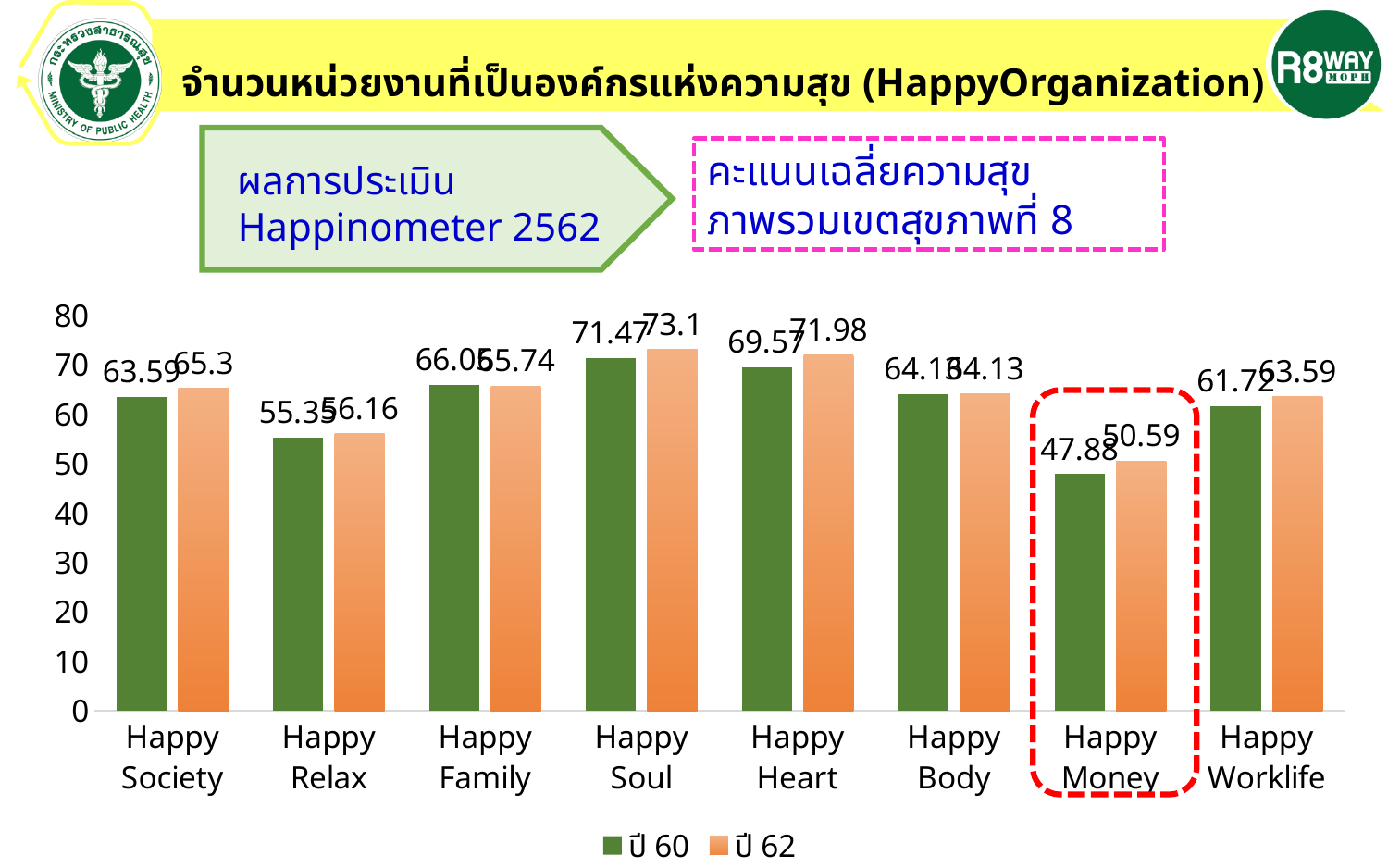
What is the difference between the ปี 62 and ปี 60 values for Happy Soul? 1.63 What kind of chart is shown on the slide? bar chart How many categories are shown on the x axis? 8 Which category has the lowest value in the ปี 60 series? Happy Money For Happy Heart, which series has the larger value, ปี 60 or ปี 62? ปี 62 How many series does the legend list? 2 Is the ปี 60 value for Happy Relax greater or less than 60? less What is the value for Happy Soul in the ปี 60 series? 71.47 What is the value for Happy Heart in the ปี 62 series? 71.98 What is the difference between the ปี 62 and ปี 60 values for Happy Money? 2.71 What is the value for Happy Money in the ปี 62 series? 50.59 Which category has the highest value in the ปี 62 series? Happy Soul